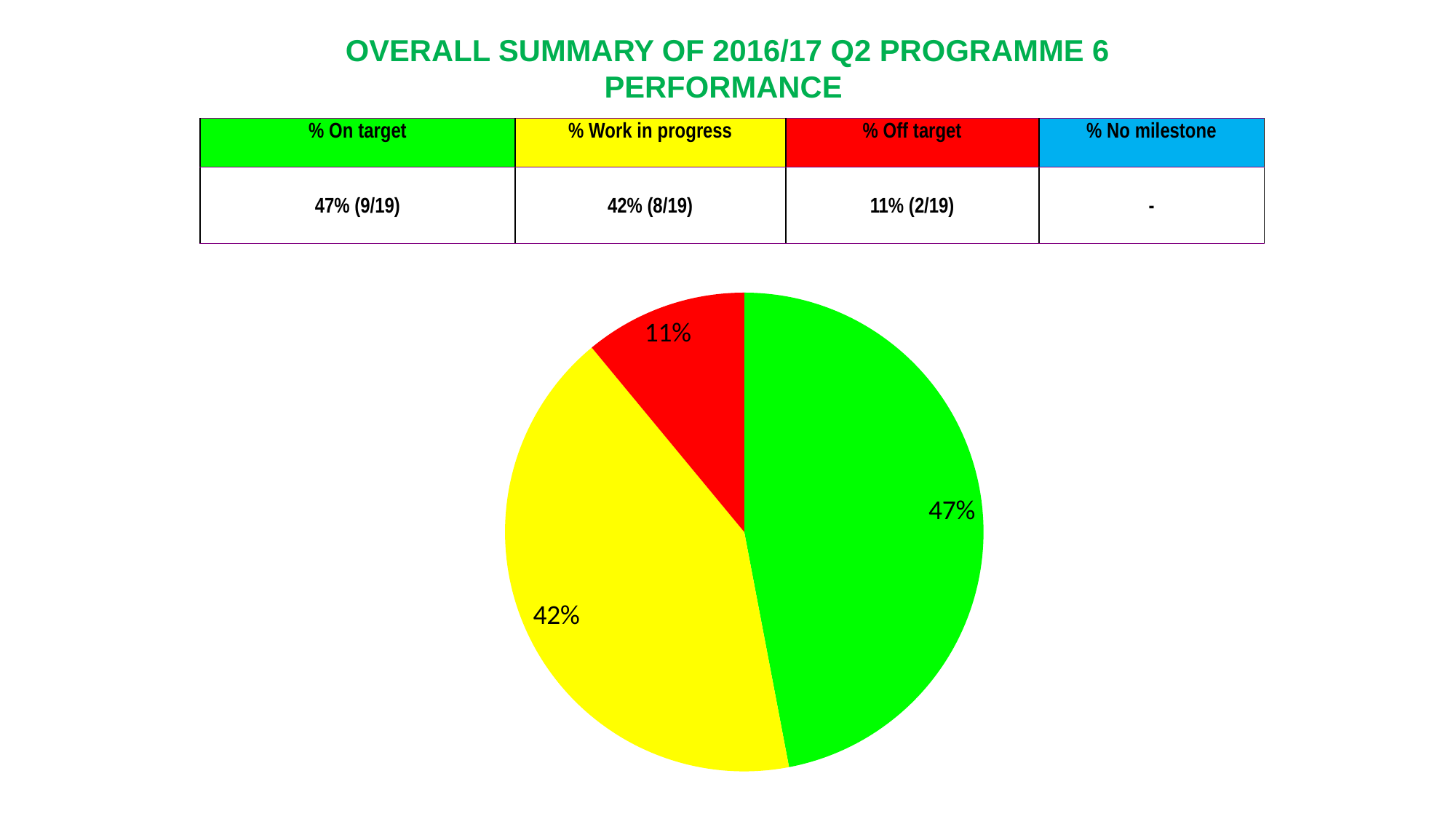
What percentage is shown on the green slice of the pie chart? 47% What is the title of the slide containing the pie chart? OVERALL SUMMARY OF 2016/17 Q2 PROGRAMME 6 PERFORMANCE Which is larger in the pie chart, the yellow slice or the red slice? Yellow slice What is the difference between the yellow slice and the red slice of the pie chart? 31% Which slice of the pie chart is the largest? Green (47%) What percentage is shown on the yellow slice of the pie chart? 42% How many slices does the pie chart have? 3 What percentage is shown on the red slice of the pie chart? 11% According to the table, what percentage of milestones are on target? 47% (9/19) Which slice of the pie chart is the smallest? Red (11%) What kind of chart is shown on the slide? Pie chart What is the difference between the green slice and the yellow slice of the pie chart? 5%